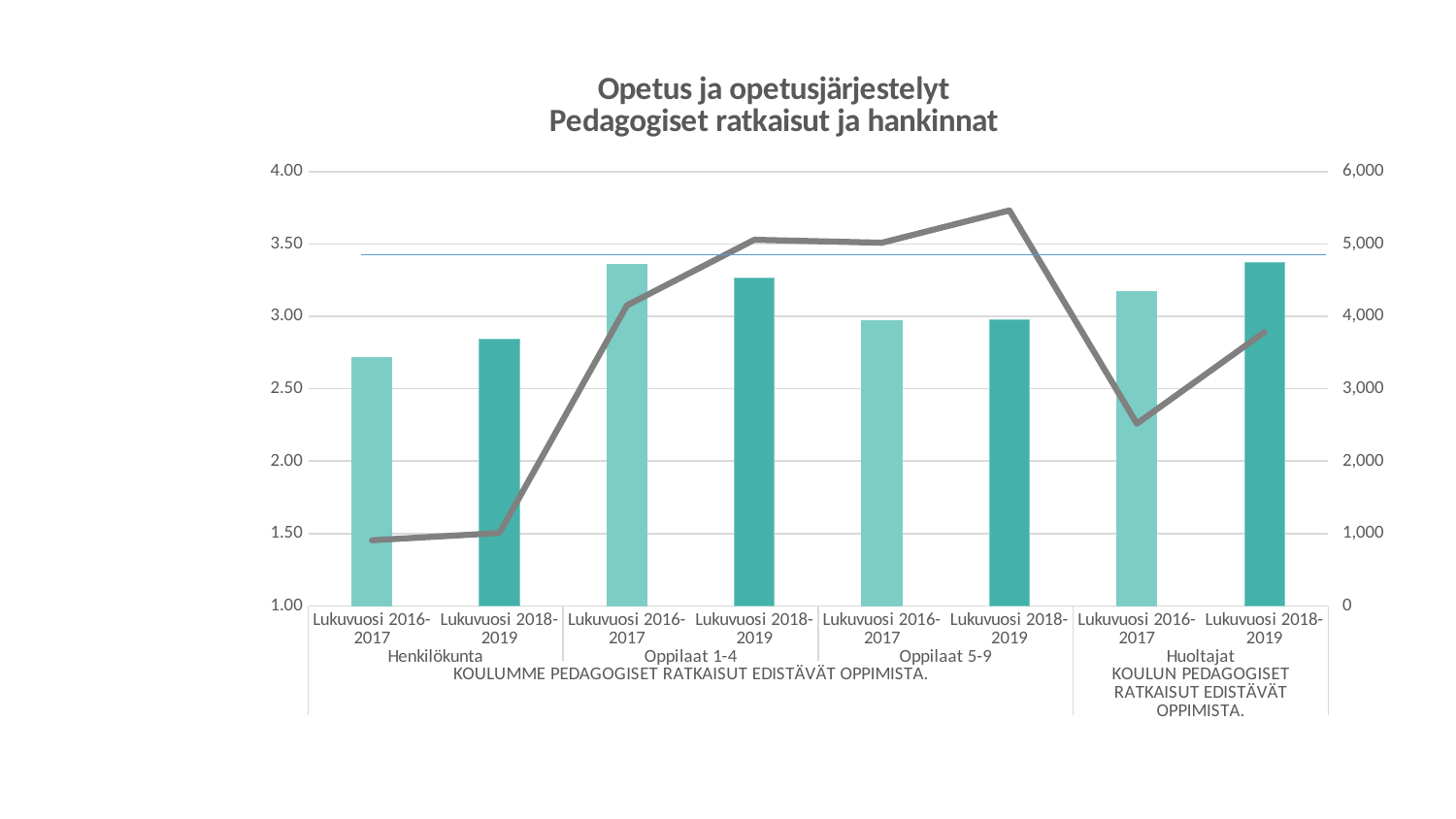
What is the title of the chart? Opetus ja opetusjärjestelyt Pedagogiset ratkaisut ja hankinnat For Henkilökunta, which bar is taller: Lukuvuosi 2016-2017 or Lukuvuosi 2018-2019? Lukuvuosi 2018-2019 For Huoltajat, which bar is taller: Lukuvuosi 2016-2017 or Lukuvuosi 2018-2019? Lukuvuosi 2018-2019 How many bars are plotted in the chart? 8 Is the bar value for Henkilökunta, Lukuvuosi 2016-2017 greater or less than 3.00? less At which category does the grey line reach its highest point? Oppilaat 5-9, Lukuvuosi 2018-2019 What kind of chart is shown on the slide? A combination bar and line chart Which bar is the lowest in the chart? Henkilökunta, Lukuvuosi 2016-2017 How many respondent groups (Henkilökunta, Oppilaat 1-4, Oppilaat 5-9, Huoltajat) are shown on the x axis? 4 Is the bar value for Huoltajat, Lukuvuosi 2018-2019 greater or less than 3.00? greater Is the grey line value for Huoltajat, Lukuvuosi 2016-2017 greater or less than 3,000 on the right axis? less